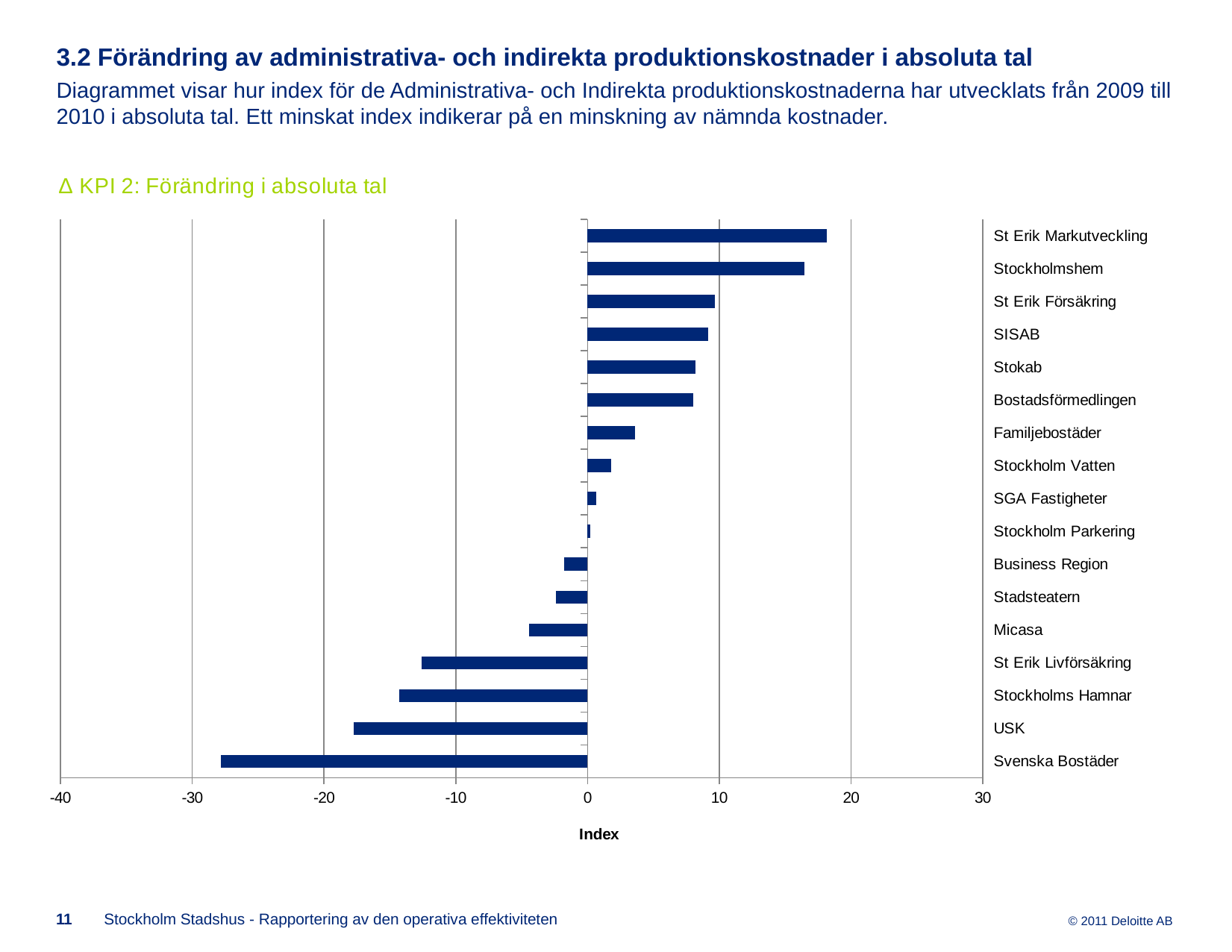
Which has the larger value, Micasa or St Erik Livförsäkring? Micasa What is the title of the horizontal axis? Index How many companies (categories) are plotted in the chart? 17 Which company has the lowest value in the chart? Svenska Bostäder What kind of chart is shown on the slide? bar chart Which company has the highest value in the chart? St Erik Markutveckling Is the value for USK greater or less than -10? less Is the value for Svenska Bostäder greater or less than -20? less Is the value for St Erik Markutveckling greater or less than 10? greater Do the values rise or fall going from the top category to the bottom category of the chart? fall Which has the larger value, Stockholmshem or SISAB? Stockholmshem